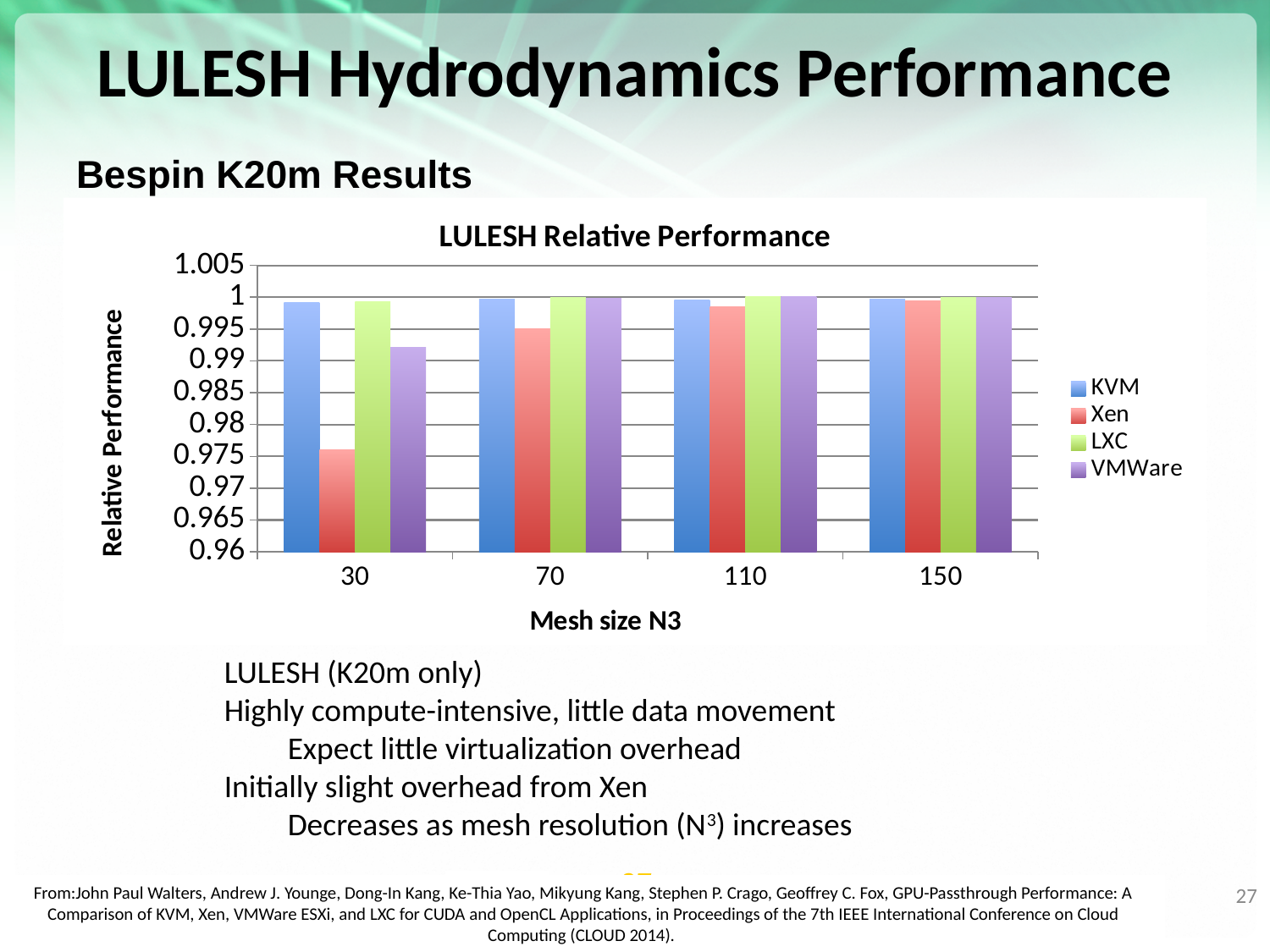
At mesh size 30, which is larger, the KVM bar or the Xen bar? KVM What is the label of the y axis of the chart? Relative Performance How many mesh size categories are shown on the x axis of the chart? 4 How many series does the legend of the LULESH Relative Performance chart list? 4 Is the value for Xen at mesh size 30 greater or less than 0.98? less Is the value for Xen at mesh size 70 greater or less than 0.99? greater Is the value for Xen at mesh size 30 greater or less than 0.97? greater At which mesh size is the Xen bar lowest? 30 What kind of chart is shown on the slide? bar chart Do the Xen values rise or fall as mesh size increases along the x axis? rise Which series has the lowest bar at mesh size 30? Xen